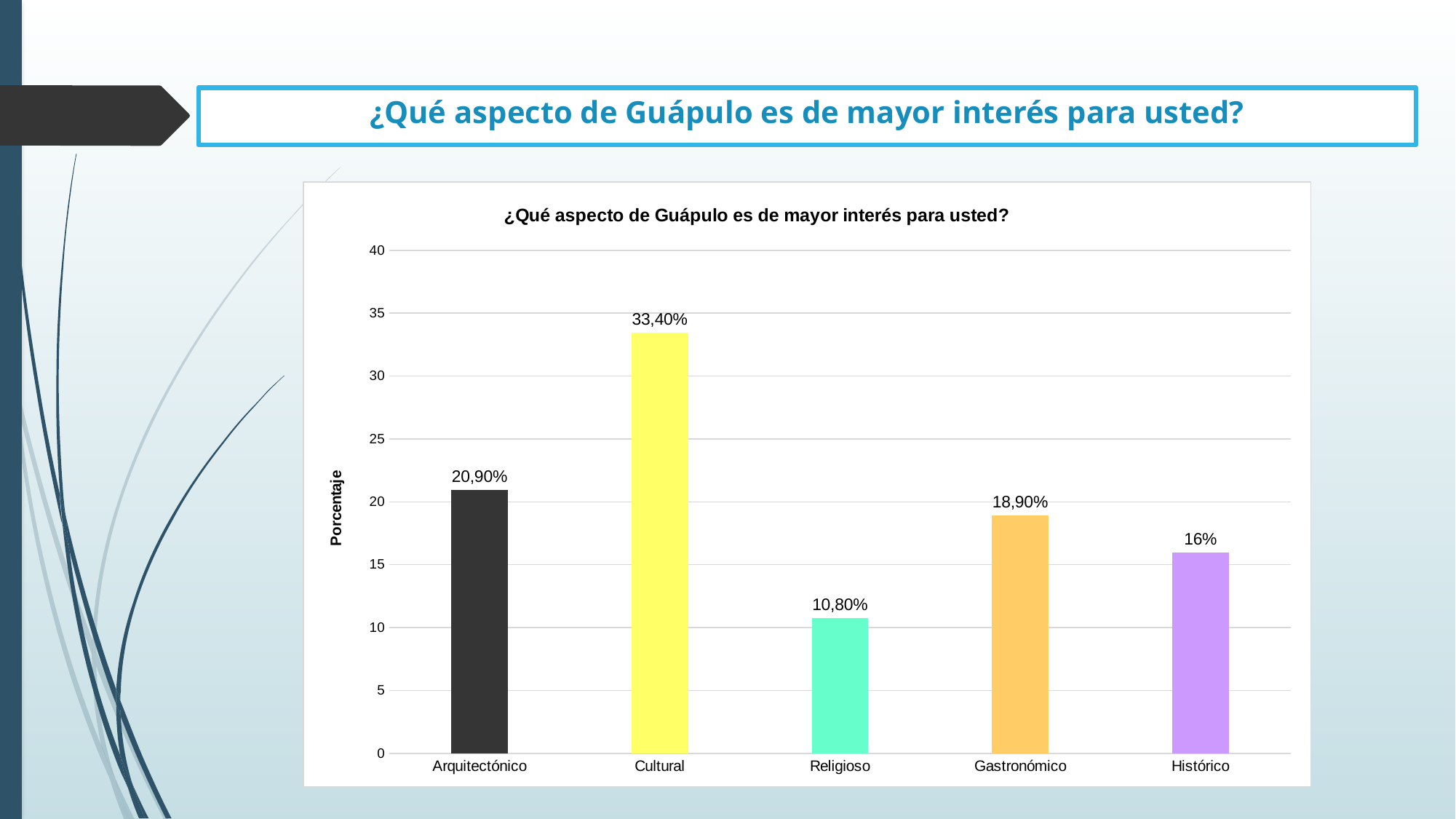
Which category has the lowest value? Religioso What is the value for Histórico? 16% What is the label of the vertical axis? Porcentaje Which category has the highest value? Cultural What is the difference between the values for Cultural and Arquitectónico? 12,50% How many categories are shown on the x axis? 5 Is the value for Histórico greater or less than 20? less What is the value for Religioso? 10,80% What is the difference between the values for Gastronómico and Histórico? 2,90% What is the value for Cultural? 33,40% Which is larger, the value for Arquitectónico or the value for Gastronómico? Arquitectónico What kind of chart is shown on the slide? bar chart